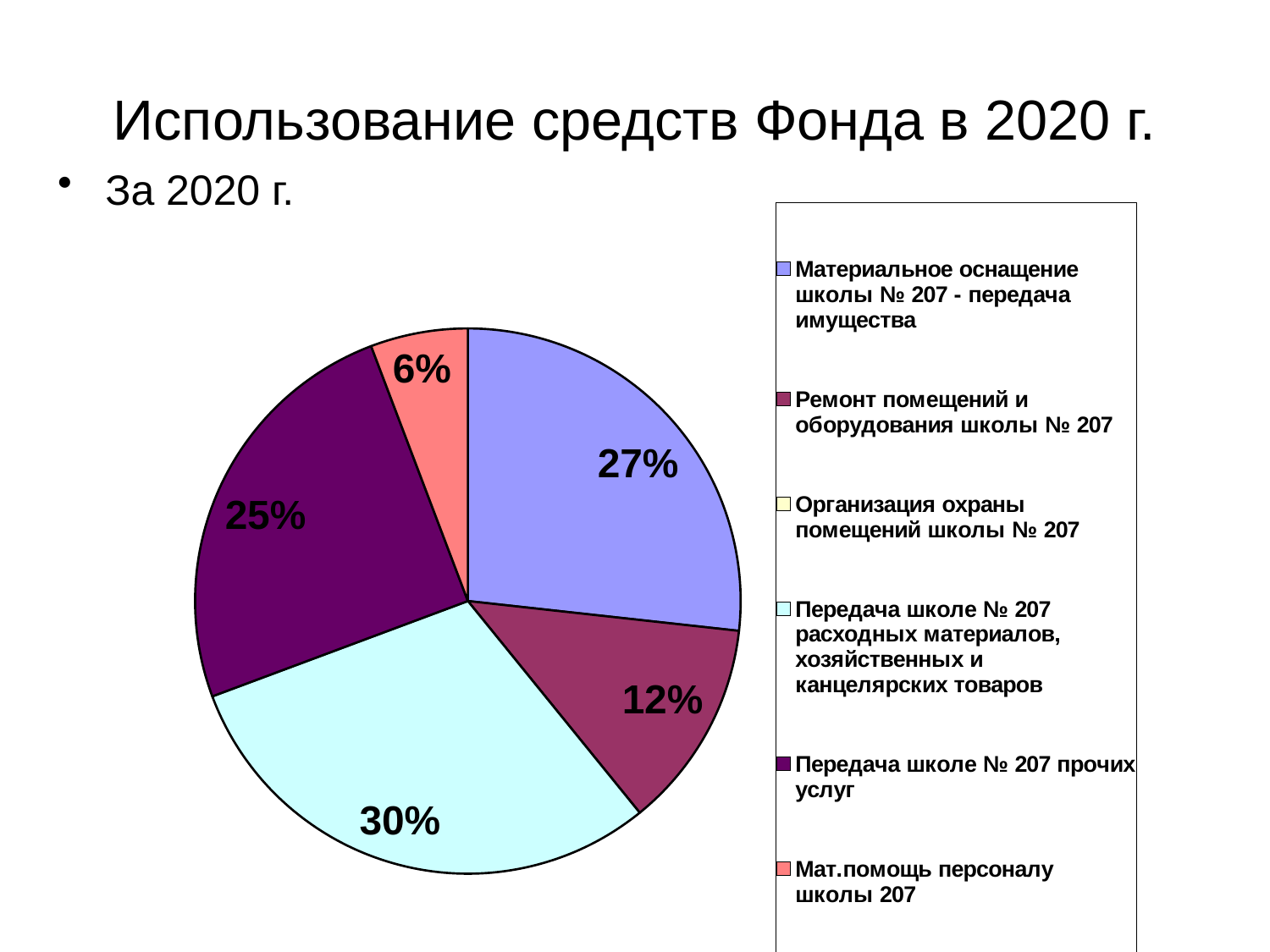
How many entries does the legend list? 6 Which category has the largest slice of the pie? Передача школе № 207 расходных материалов, хозяйственных и канцелярских товаров What is the title of the slide containing the chart? Использование средств Фонда в 2020 г. What share of the pie is labelled for "Ремонт помещений и оборудования школы № 207"? 12% What share of the pie is labelled for "Передача школе № 207 расходных материалов, хозяйственных и канцелярских товаров"? 30% Which category with a visible slice has the smallest share of the pie? Мат.помощь персоналу школы 207 What is the difference in percentage points between the slice for "Передача школе № 207 расходных материалов, хозяйственных и канцелярских товаров" and the slice for "Ремонт помещений и оборудования школы № 207"? 18 percentage points Which is larger: the slice for "Материальное оснащение школы № 207 - передача имущества" or the slice for "Передача школе № 207 прочих услуг"? Материальное оснащение школы № 207 - передача имущества What share of the pie is labelled for "Мат.помощь персоналу школы 207"? 6% What share of the pie is labelled for "Материальное оснащение школы № 207 - передача имущества"? 27% What kind of chart is shown on the slide? pie chart What share of the pie is labelled for "Передача школе № 207 прочих услуг"? 25%